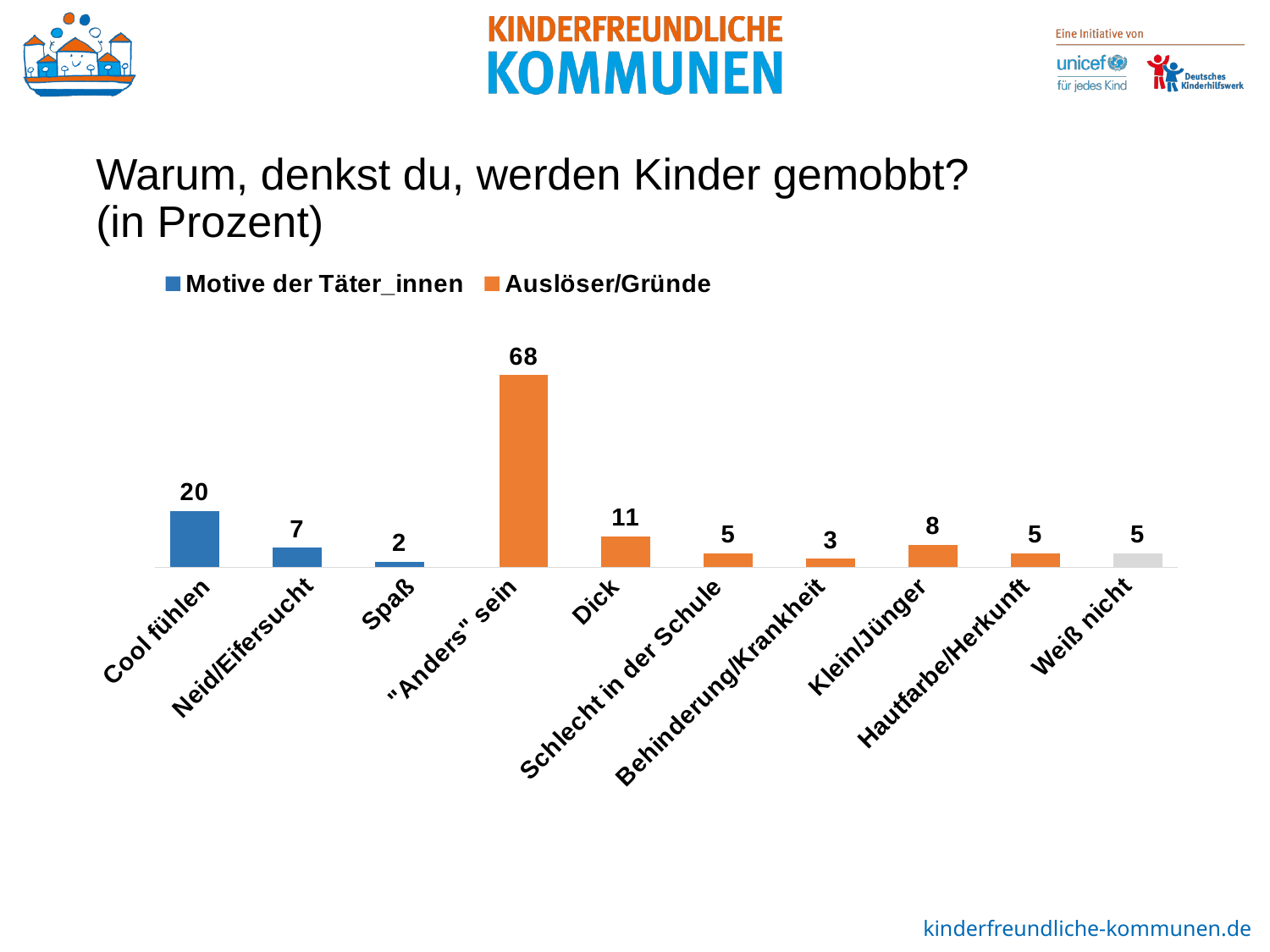
What value is shown for Behinderung/Krankheit? 3 Which category has the lowest value? Spaß Which category has the highest value? "Anders" sein How many categories are shown on the x axis? 10 Which series does the legend show in orange? Auslöser/Gründe What value is shown for "Anders" sein? 68 How many series does the legend list? 2 What value is shown for Klein/Jünger? 8 What kind of chart is shown on the slide? Bar chart What is the difference between the values for "Anders" sein and Cool fühlen? 48 Which is larger, the value for Dick or the value for Klein/Jünger? Dick What value is shown for Cool fühlen? 20